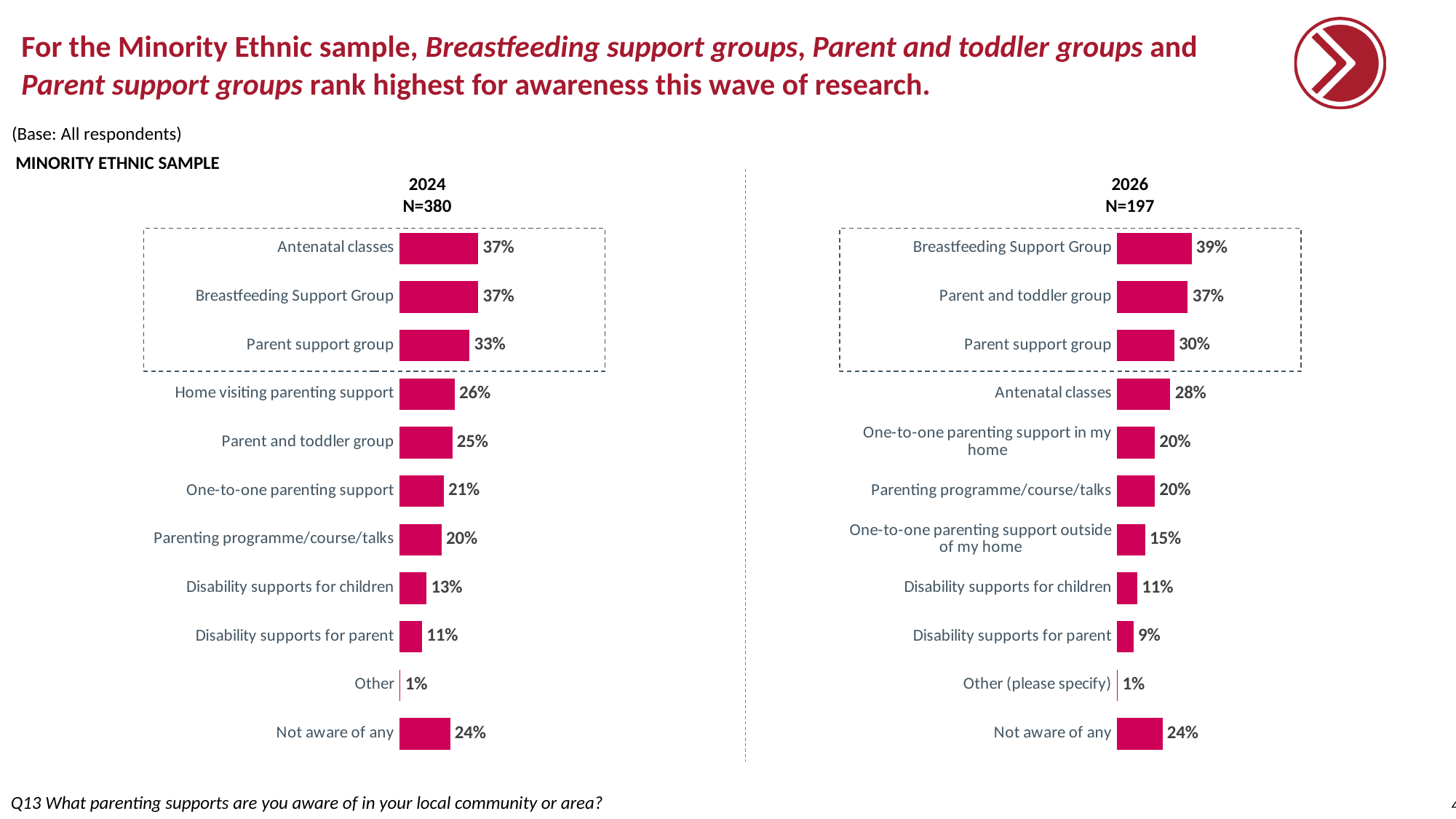
In the 2024 chart, what is the value for Home visiting parenting support? 26% In the 2026 chart, what is the difference between Breastfeeding Support Group and Antenatal classes? 11% What is the sample size (N) shown for the 2026 chart? N=197 In the 2026 chart, which is larger: Parent support group or Not aware of any? Parent support group In the 2024 chart, which category has the lowest value? Other In the 2024 chart, what is the difference between Antenatal classes and Parent support group? 4% How many categories are shown in the 2026 chart? 11 In the 2026 chart, what is the value for Parent and toddler group? 37% In the 2024 chart, what is the value for Not aware of any? 24% In the 2026 chart, which category has the highest value? Breastfeeding Support Group In the 2024 chart, which is larger: Disability supports for children or Disability supports for parent? Disability supports for children What kind of chart is the 2024 chart? Bar chart